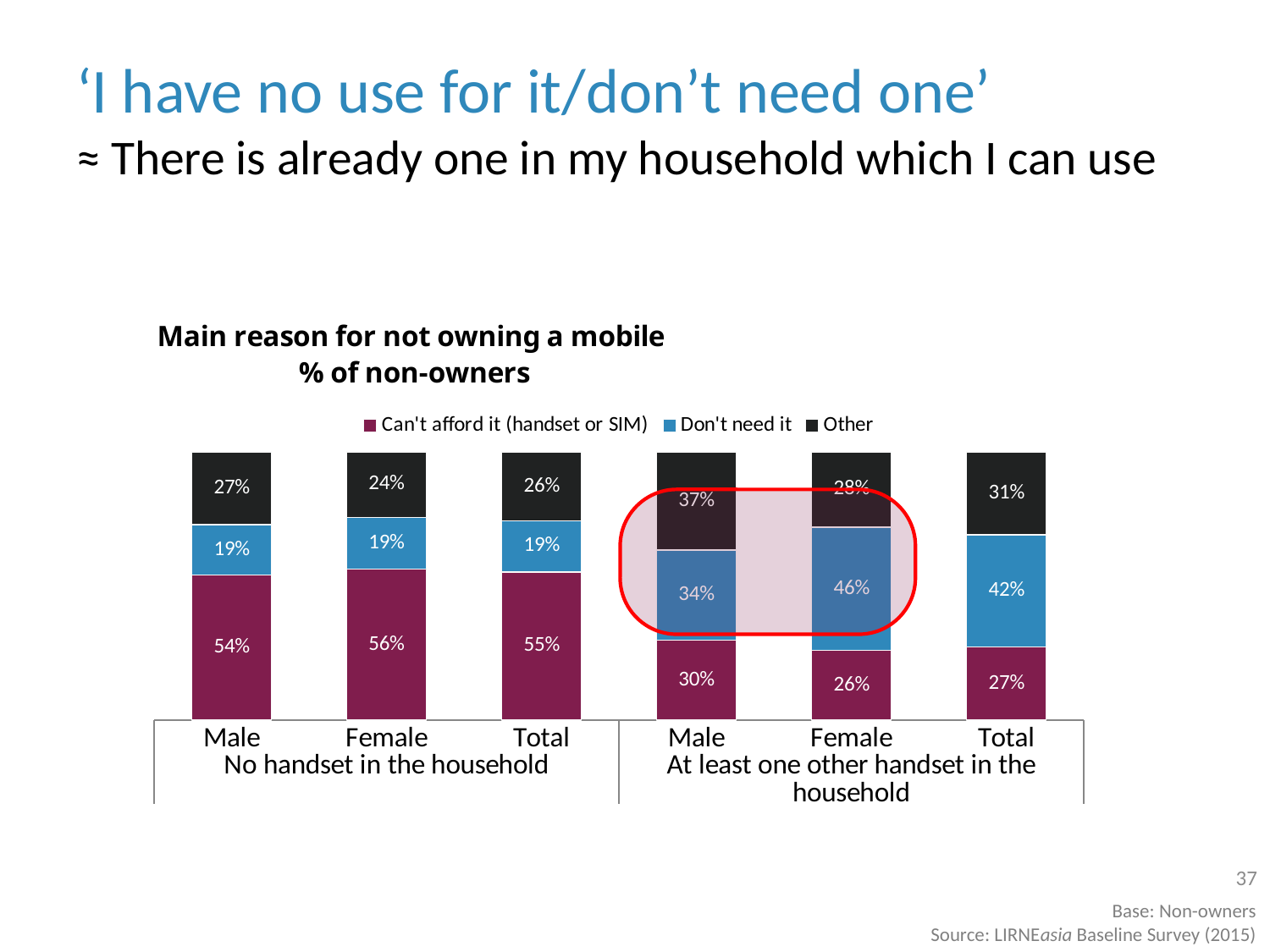
How many series does the legend list? 3 What is the 'Don't need it' value for Total in the 'No handset in the household' group? 19% What is the title of the chart? Main reason for not owning a mobile % of non-owners What kind of chart is shown on the slide? Stacked bar chart What is the difference between the 'Don't need it' values for Total in the 'At least one other handset in the household' group and Total in the 'No handset in the household' group? 23 percentage points Which is larger: the 'Can't afford it (handset or SIM)' value for Male in the 'No handset in the household' group or for Male in the 'At least one other handset in the household' group? Male, No handset in the household What is the 'Can't afford it (handset or SIM)' value for Female in the 'No handset in the household' group? 56% What is the 'Don't need it' value for Female in the 'At least one other handset in the household' group? 46% What is the 'Other' value for Male in the 'At least one other handset in the household' group? 37% Which bar has the highest 'Don't need it' value? Female, At least one other handset in the household Which bar has the lowest 'Can't afford it (handset or SIM)' value? Female, At least one other handset in the household How many bars are plotted in the chart? 6